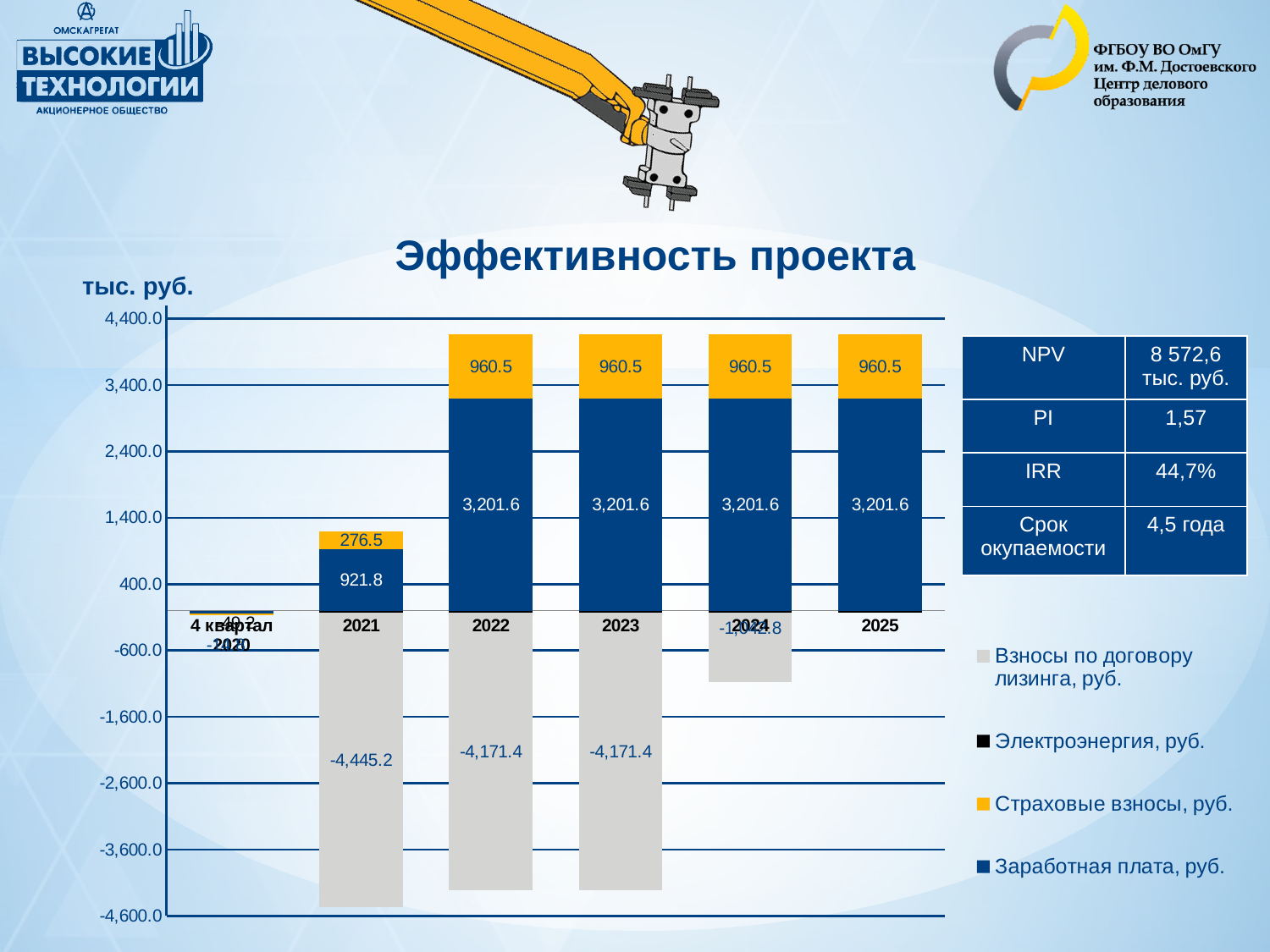
What unit label is shown above the vertical axis of the chart? тыс. руб. What is the value of 'Взносы по договору лизинга, руб.' for 2021? -4,445.2 Which is larger: 'Страховые взносы, руб.' in 2021 or in 2025? 2025 What is the value of 'Страховые взносы, руб.' for 2021? 276.5 How many categories (periods) are shown on the x axis of the chart? 6 What is the value of 'Взносы по договору лизинга, руб.' for 2023? -4,171.4 What type of chart is shown on the slide? Bar chart How many series does the chart legend list? 4 In which year is the 'Взносы по договору лизинга, руб.' value the lowest (most negative)? 2021 By how much does 'Заработная плата, руб.' in 2022 exceed the value in 2021? 2,279.8 What is the value of 'Заработная плата, руб.' for 2022? 3,201.6 What is the difference between 'Страховые взносы, руб.' in 2025 and in 2021? 684.0